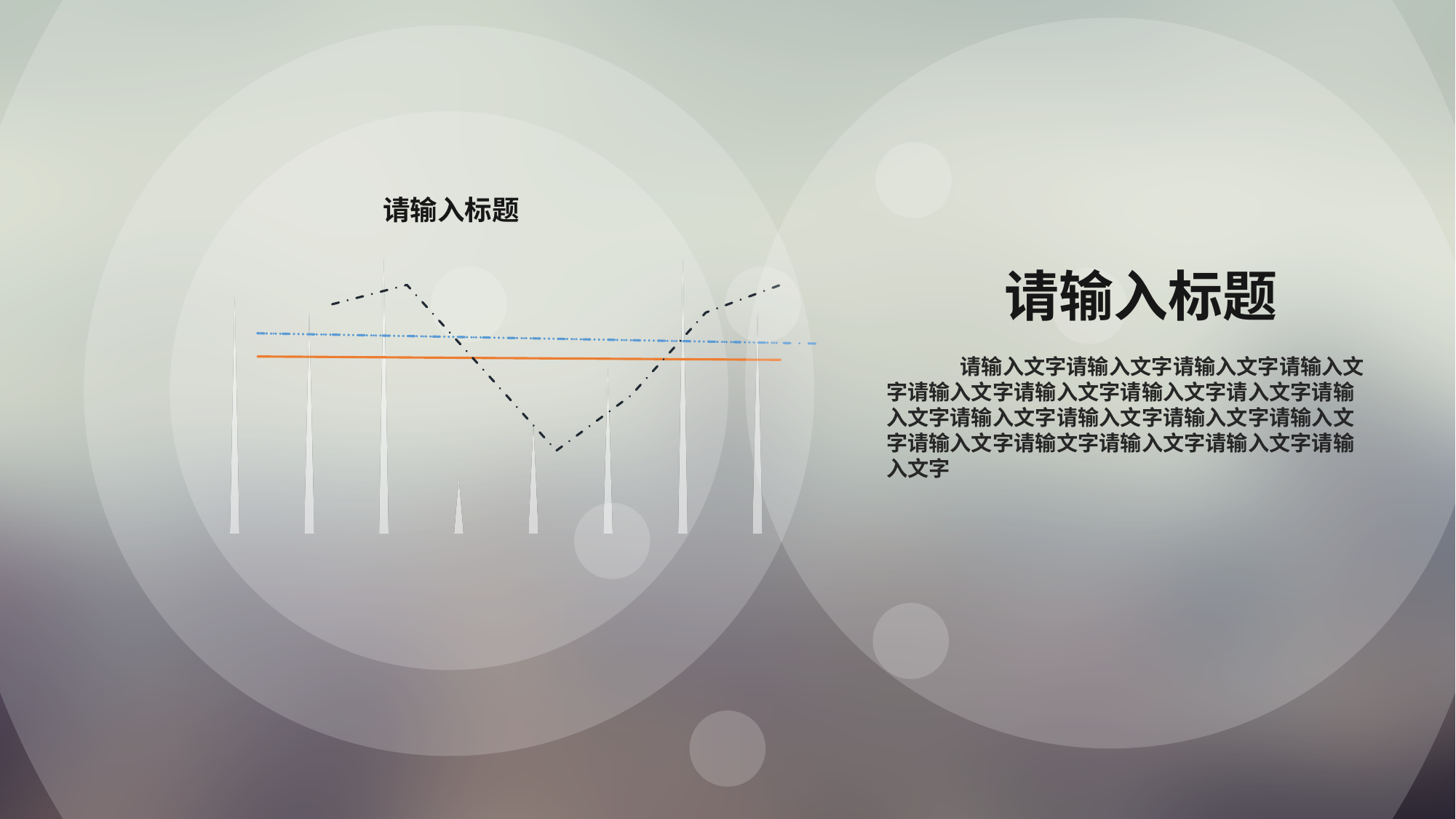
What kind of chart is shown on the slide? bar chart with line series How many line series are drawn across the bars in the chart? 3 What colour is the solid line drawn across the chart? orange Which bar is the shortest in the chart, counting from the left? the fourth bar How many bars (spikes) are plotted in the chart? 8 What is the title shown above the chart? 请输入标题